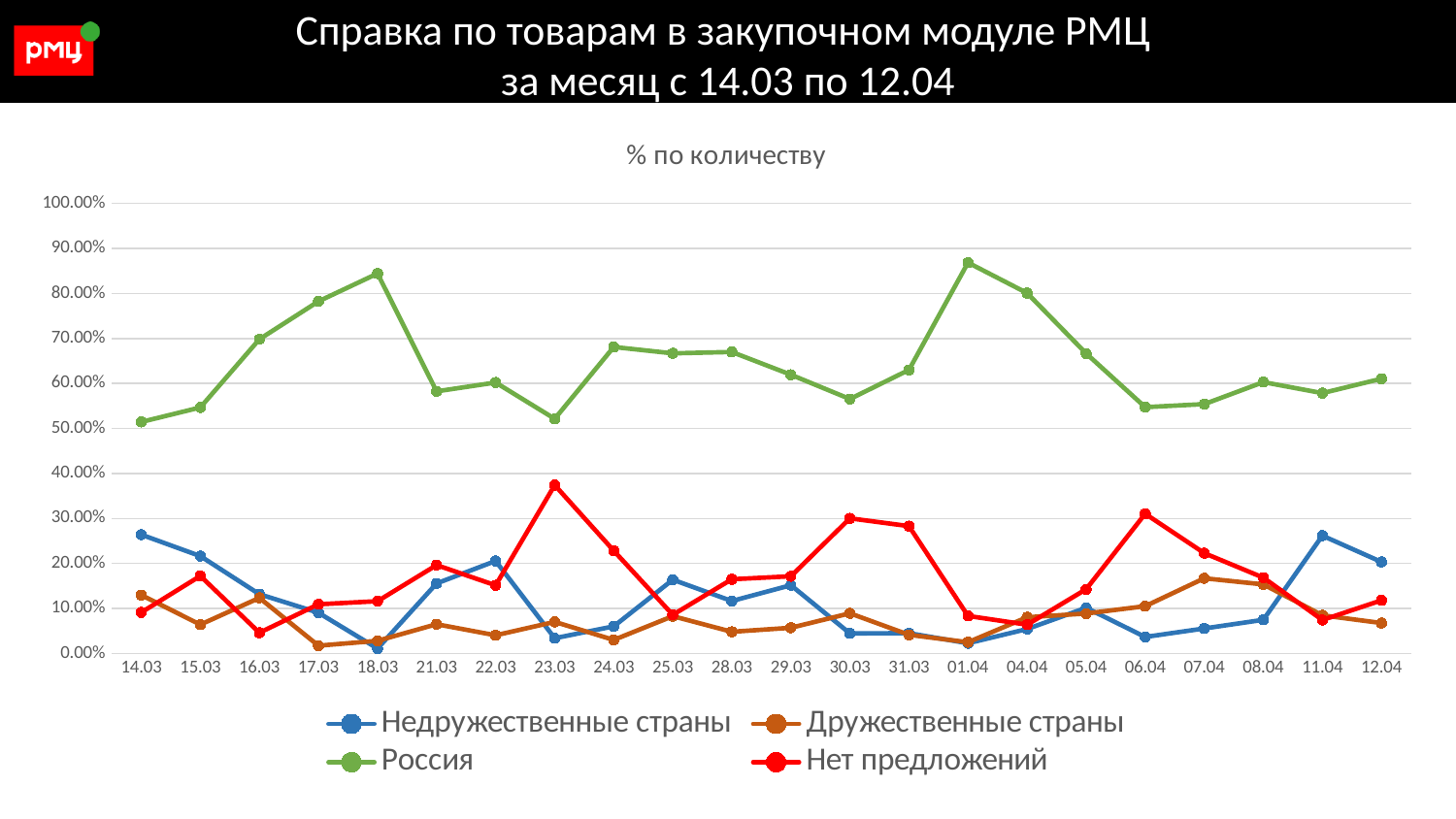
On 14.03, which is larger: Недружественные страны or Нет предложений? Недружественные страны What is the title of the chart? % по количеству On which date does the Россия series reach its highest value? 01.04 Which series is drawn in green? Россия Is the value for Россия on 01.04 greater or less than 80.00%? greater On which date does the Нет предложений series reach its highest value? 23.03 How many dates are shown on the x axis? 22 What kind of chart is shown on the slide? line chart Is the value for Недружественные страны on 18.03 greater or less than 10.00%? less Is the value for Россия on 14.03 greater or less than 60.00%? less How many series does the legend list? 4 On which date does the Дружественные страны series reach its highest value? 07.04